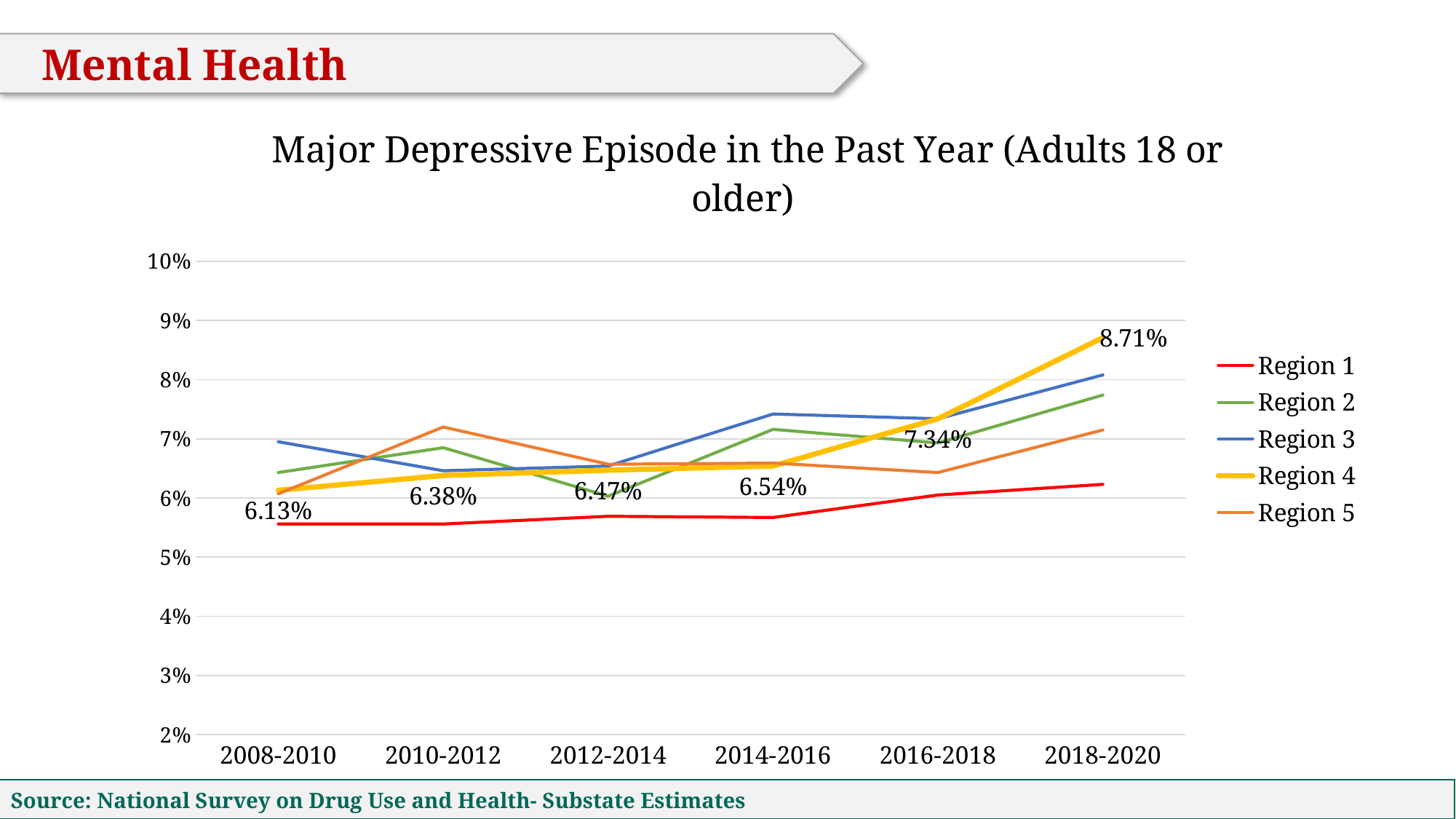
What is the value for Region 4 in 2016-2018? 7.34% In 2008-2010, which is larger: Region 3 or Region 5? Region 3 How many series does the legend list? 5 What is the value for Region 4 in 2008-2010? 6.13% What kind of chart is shown on the slide? Line chart Which region has the highest value in 2018-2020? Region 4 Is the value for Region 1 in 2008-2010 greater or less than 6%? less How many time periods are shown on the x axis? 6 What is the value for Region 4 in 2018-2020? 8.71% Does the Region 4 line rise or fall from 2008-2010 to 2018-2020? Rises Which region has the lowest value in 2018-2020? Region 1 By how much did the Region 4 value increase from 2008-2010 to 2018-2020? 2.58 percentage points